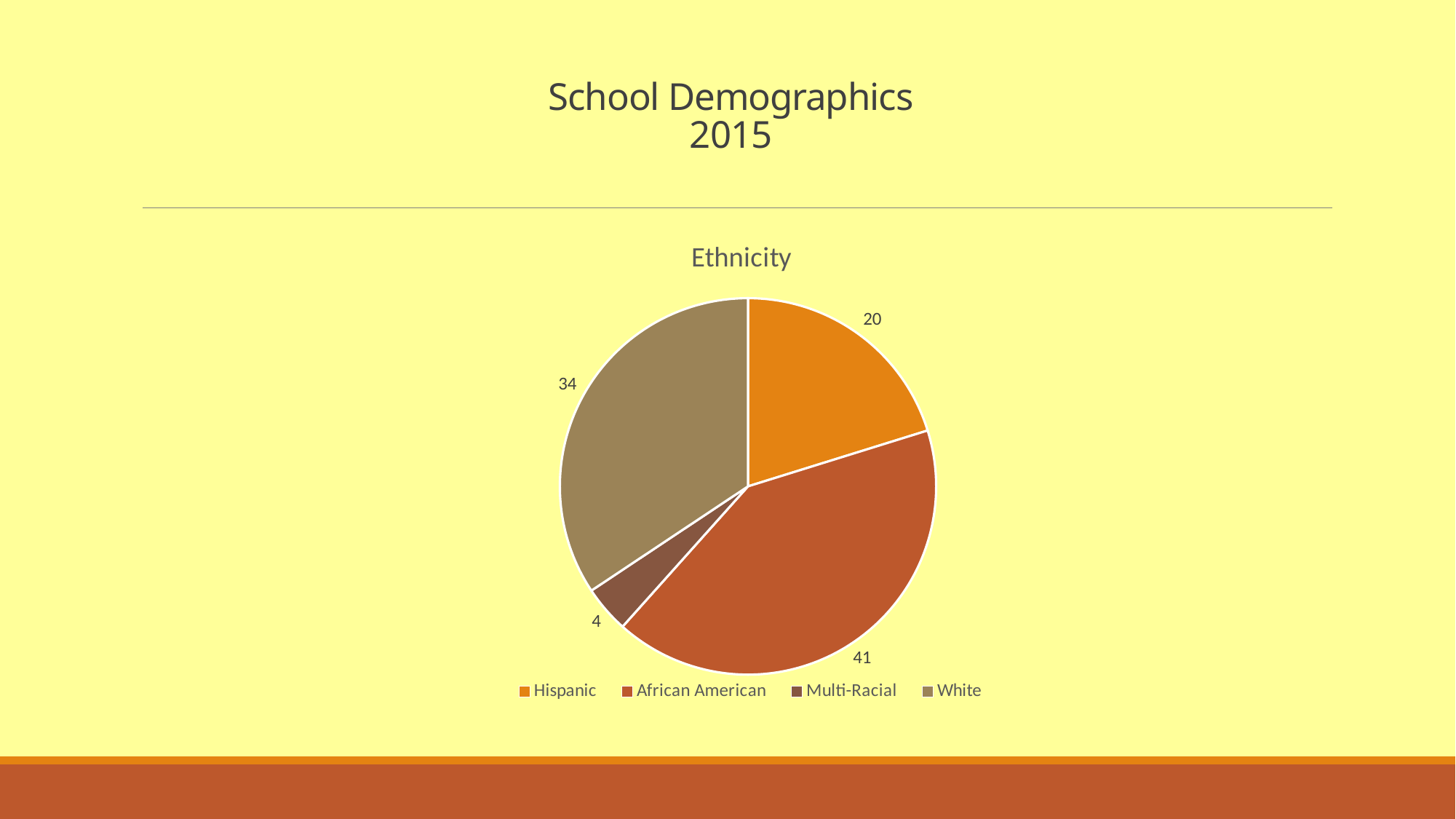
What is the value for Multi-Racial in the Ethnicity pie chart? 4 What is the value for Hispanic in the Ethnicity pie chart? 20 Which is larger in the Ethnicity pie chart, the value for White or the value for Hispanic? White What is the value for African American in the Ethnicity pie chart? 41 Which category has the largest slice in the Ethnicity pie chart? African American Which category has the smallest slice in the Ethnicity pie chart? Multi-Racial What is the title of the chart on the slide? Ethnicity How many categories are shown in the Ethnicity pie chart? 4 What is the difference between the African American and White values in the Ethnicity pie chart? 7 What kind of chart is shown on the slide? Pie chart What is the value for White in the Ethnicity pie chart? 34 What is the difference between the Hispanic and Multi-Racial values in the Ethnicity pie chart? 16